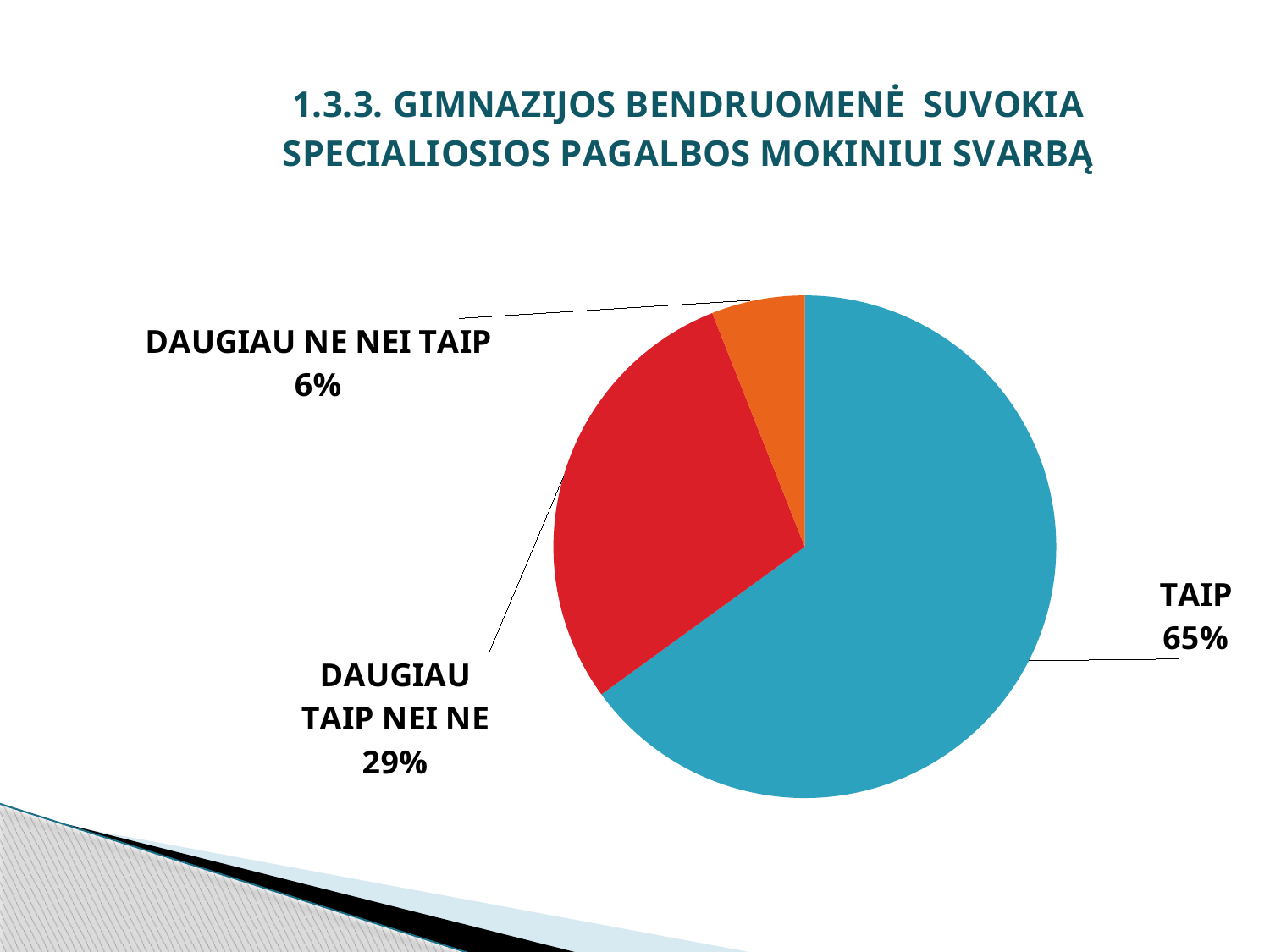
What colour is the TAIP slice of the pie? blue How many slices does the pie chart have? 3 Which slice of the pie is the smallest? DAUGIAU NE NEI TAIP What percentage of the pie is labelled DAUGIAU TAIP NEI NE? 29% What percentage of the pie is labelled DAUGIAU NE NEI TAIP? 6% What is the difference in percentage points between the DAUGIAU TAIP NEI NE slice and the DAUGIAU NE NEI TAIP slice? 23 Which is larger, the DAUGIAU TAIP NEI NE slice or the DAUGIAU NE NEI TAIP slice? DAUGIAU TAIP NEI NE What kind of chart is shown on the slide? pie chart What is the difference in percentage points between the TAIP slice and the DAUGIAU TAIP NEI NE slice? 36 What percentage of the pie is labelled TAIP? 65% Which slice of the pie is the largest? TAIP What colour is the DAUGIAU NE NEI TAIP slice of the pie? orange